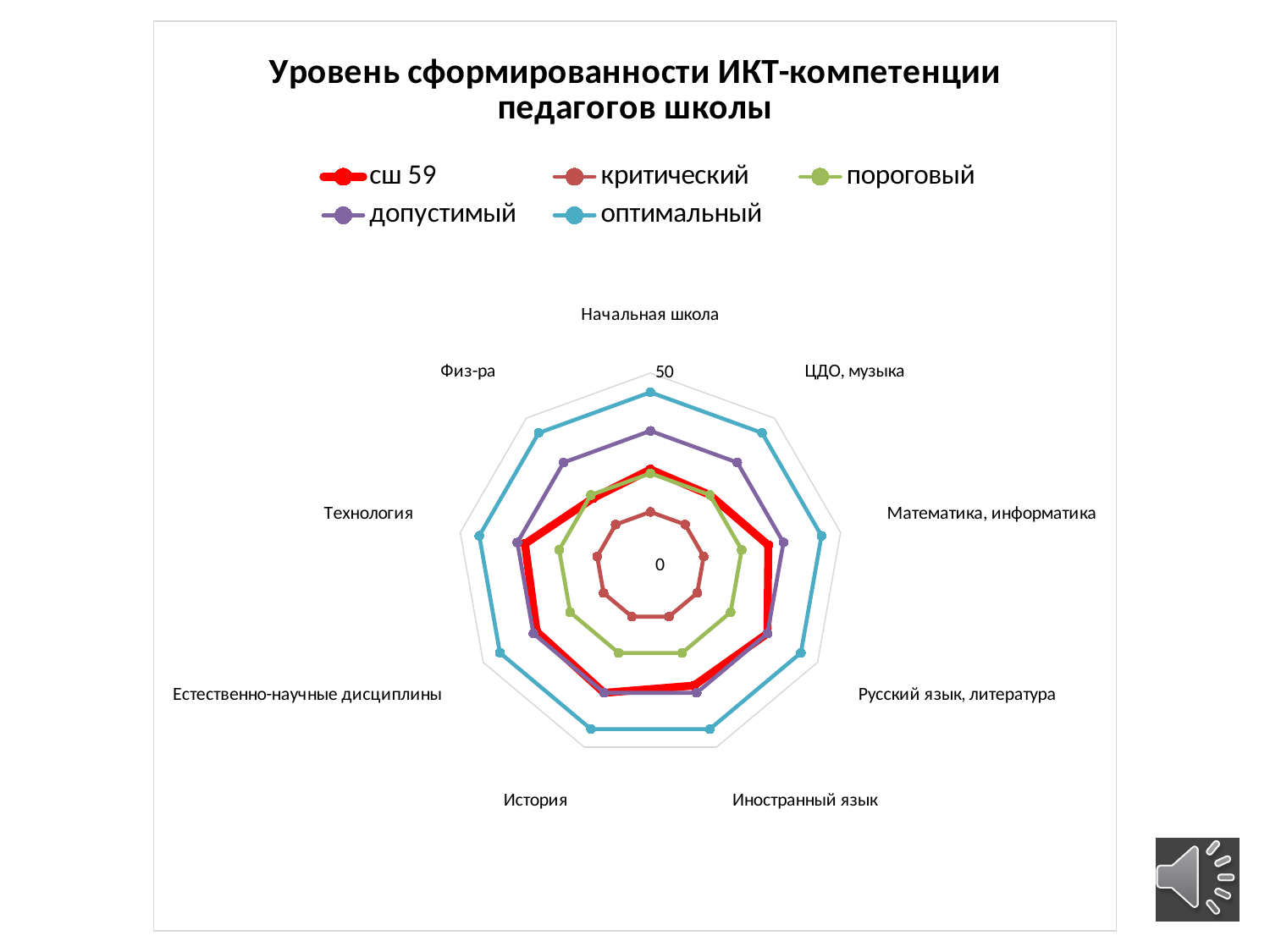
How many categories (axes) does the radar chart have? 9 For Физ-ра, which series has the larger value: допустимый or пороговый? допустимый For the сш 59 series, which is larger: the value for Русский язык, литература or the value for Начальная школа? Русский язык, литература Is the value of the критический series for Математика, информатика greater or less than 50? less What kind of chart is shown on the slide? radar chart How many series does the legend list? 5 Is the value of the сш 59 series for Начальная школа greater or less than 50? less Which series is drawn as the outermost polygon on the chart? оптимальный What is the title of the chart? Уровень сформированности ИКТ-компетенции педагогов школы For Начальная школа, which series has the larger value: оптимальный or критический? оптимальный Which series is drawn as the innermost polygon on the chart? критический What is the maximum value shown on the radial axis? 50